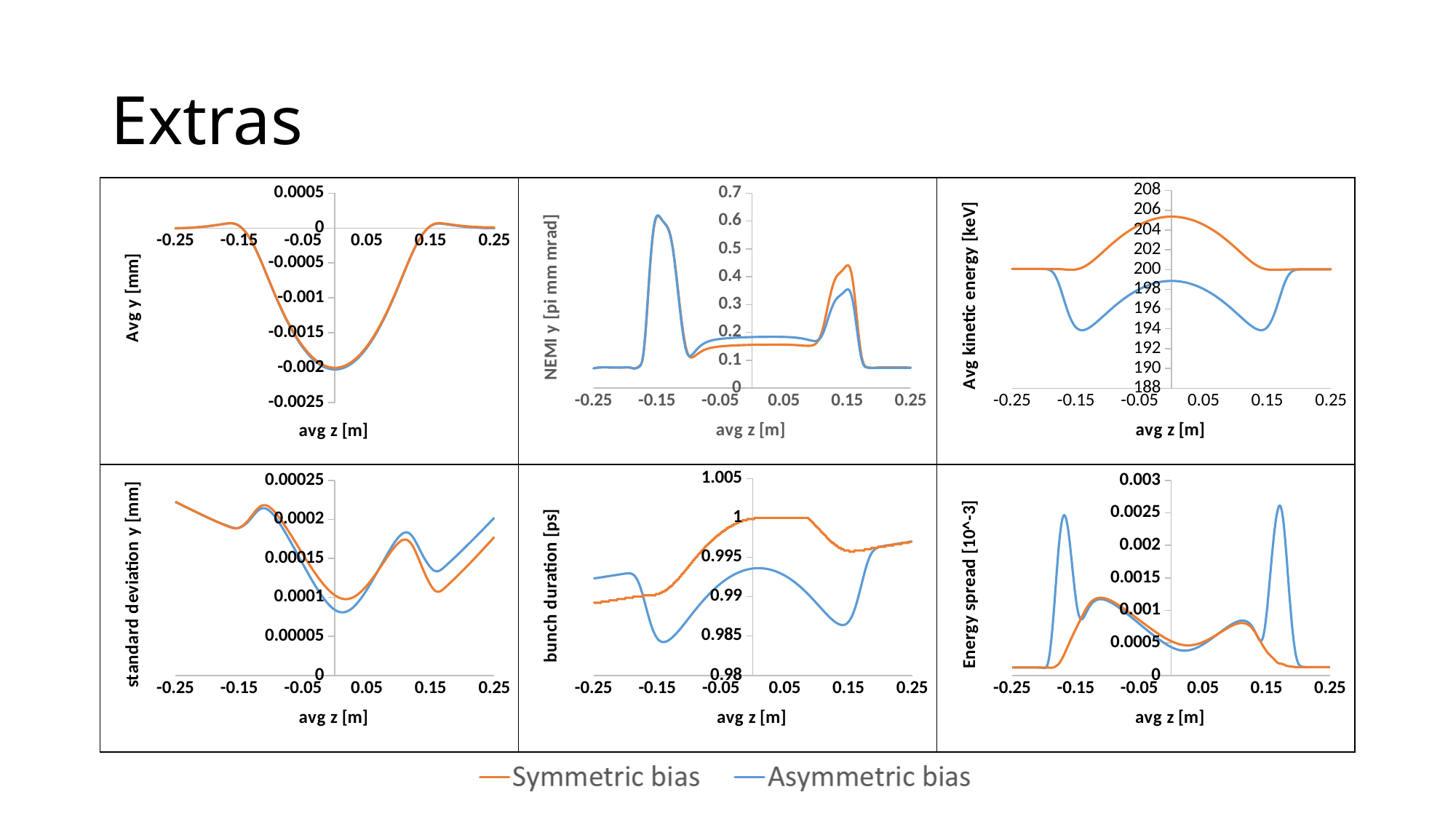
In the Avg kinetic energy [keV] chart, which series is higher at avg z = 0? Symmetric bias In the bunch duration [ps] chart, is the minimum value of the Asymmetric bias series greater or less than 0.99? less In the NEMI y [pi mm mrad] chart, is the peak of the Asymmetric bias series near avg z = -0.15 greater or less than 0.5? greater In the Avg y [mm] chart, is the minimum value of the curves greater or less than -0.0015? less What kind of chart is the Avg kinetic energy [keV] chart? line chart In the NEMI y [pi mm mrad] chart, which series is higher at avg z = 0.15? Symmetric bias How many series does the legend at the bottom of the slide list? 2 What are the two series named in the legend? Symmetric bias and Asymmetric bias What is the x-axis label shared by all six charts? avg z [m]